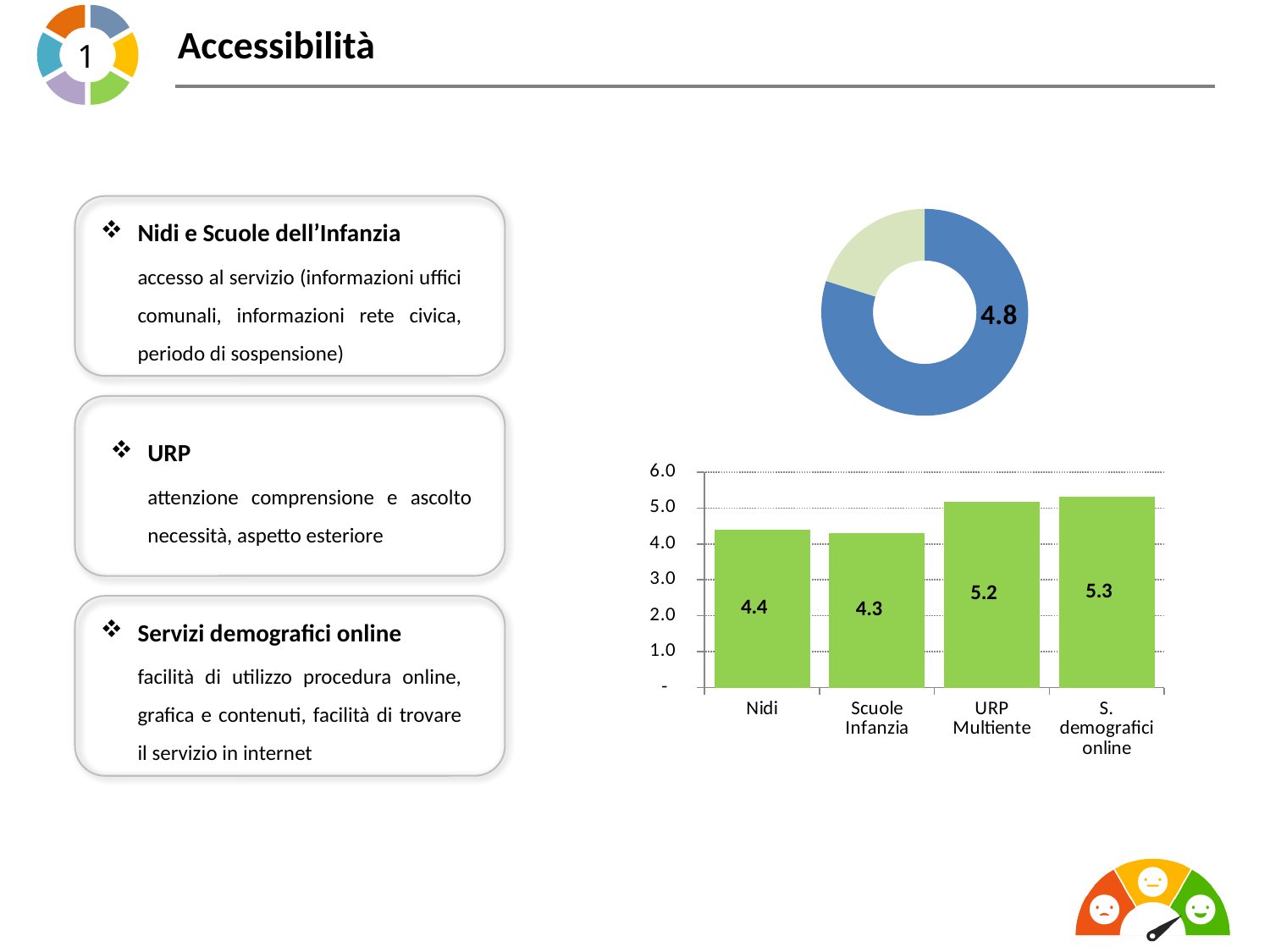
In the bar chart, which category has the lowest value? Scuole Infanzia In the bar chart, is the value for URP Multiente greater or less than 5.0? greater What value is printed in the centre of the doughnut chart at the top right of the slide? 4.8 In the bar chart, what is the value for URP Multiente? 5.2 What kind of chart is the lower chart on the right of the slide? bar chart How many categories are shown in the bar chart? 4 In the bar chart, which is larger: the value for Nidi or the value for URP Multiente? URP Multiente In the bar chart, which category has the highest value? S. demografici online In the bar chart, what is the value for S. demografici online? 5.3 In the bar chart, what is the difference between the values for S. demografici online and Scuole Infanzia? 1.0 In the bar chart, what is the value for Nidi? 4.4 In the bar chart, what is the value for Scuole Infanzia? 4.3